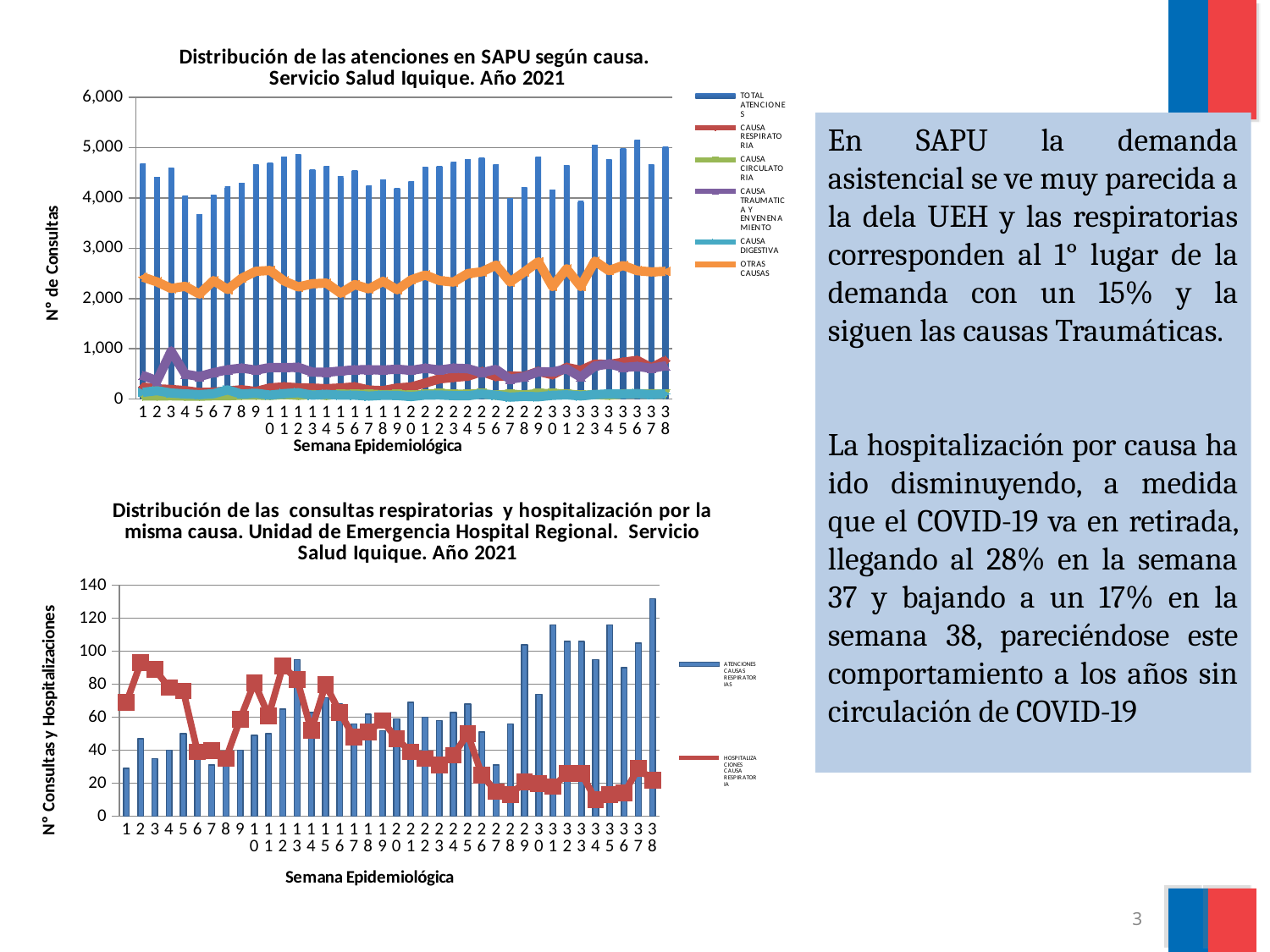
On the bottom chart (Distribución de las consultas respiratorias y hospitalización), how many series does the legend list? 2 On the top chart (Distribución de las atenciones en SAPU según causa), how many series does the legend list? 6 On the top chart (Distribución de las atenciones en SAPU según causa), which epidemiological week has the lowest TOTAL ATENCIONES bar? 5 On the bottom chart (Distribución de las consultas respiratorias y hospitalización), is the HOSPITALIZACIONES CAUSA RESPIRATORIA value for week 2 greater or less than 80? greater On the bottom chart (Distribución de las consultas respiratorias y hospitalización), what is the label of the x axis? Semana Epidemiológica On the top chart (Distribución de las atenciones en SAPU según causa), is the TOTAL ATENCIONES value for week 5 greater or less than 4,000? less On the top chart (Distribución de las atenciones en SAPU según causa), is the TOTAL ATENCIONES value for week 1 greater or less than 4,000? greater On the top chart (Distribución de las atenciones en SAPU según causa), which series is drawn in orange? OTRAS CAUSAS On the bottom chart (Distribución de las consultas respiratorias y hospitalización), which epidemiological week has the highest ATENCIONES CAUSAS RESPIRATORIAS bar? 38 On the bottom chart (Distribución de las consultas respiratorias y hospitalización), which is larger: the ATENCIONES CAUSAS RESPIRATORIAS bar for week 1 or for week 38? week 38